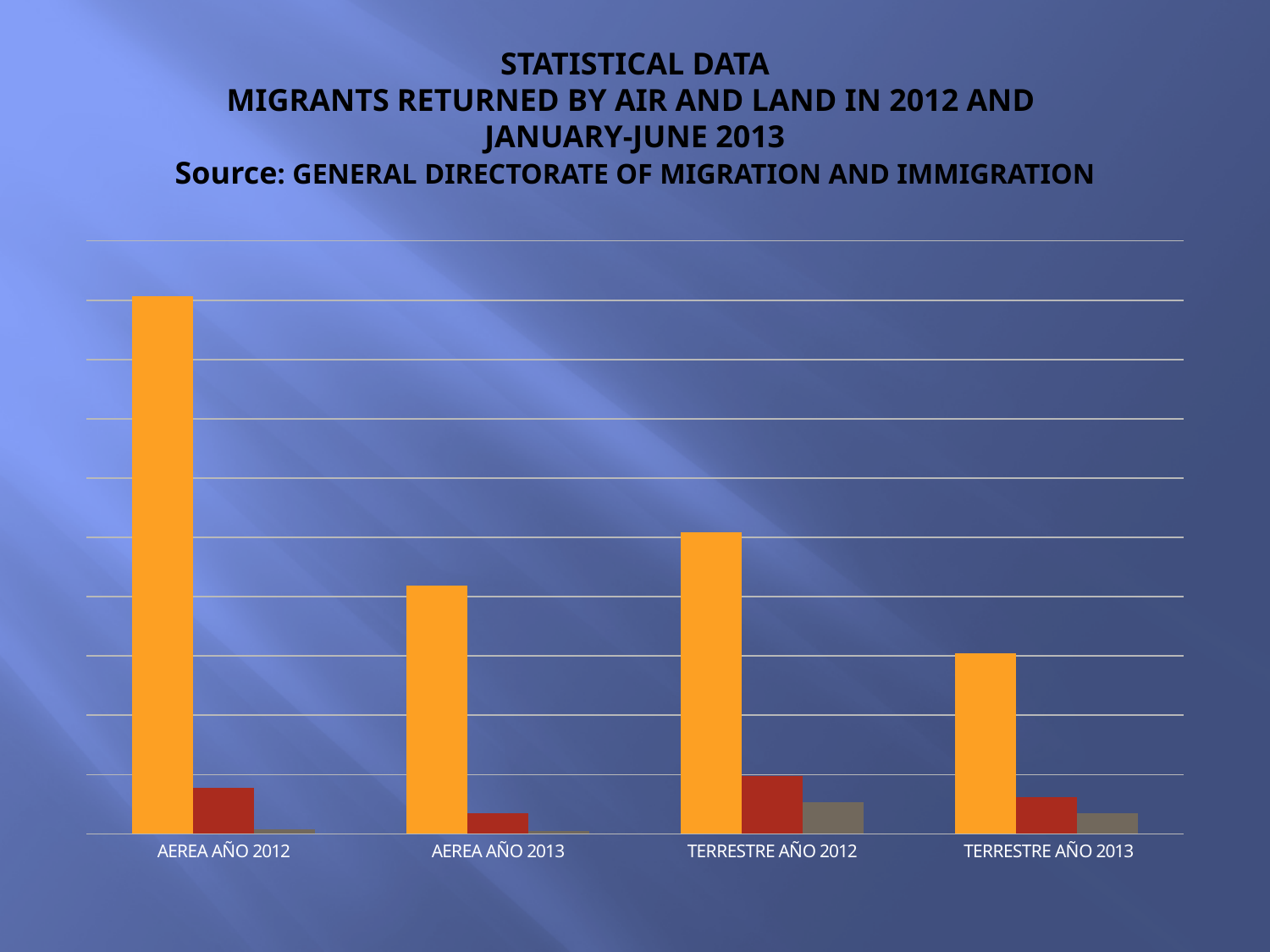
Which category has the tallest orange bar? AEREA AÑO 2012 Is the orange bar for AEREA AÑO 2013 taller or shorter than the orange bar for TERRESTRE AÑO 2012? shorter Which category has the tallest red bar? TERRESTRE AÑO 2012 What kind of chart is shown on the slide? bar chart How many categories are shown on the x axis of the chart? 4 Which category has the shortest orange bar? TERRESTRE AÑO 2013 Within each category, which colour of bar is the tallest? orange Is the orange bar for AEREA AÑO 2012 taller or shorter than the orange bar for TERRESTRE AÑO 2012? taller Is the red bar for AEREA AÑO 2012 taller or shorter than the red bar for AEREA AÑO 2013? taller How many bars are shown for each category? 3 Does the orange bar for AEREA rise or fall from AÑO 2012 to AÑO 2013? fall Does the orange bar for TERRESTRE rise or fall from AÑO 2012 to AÑO 2013? fall